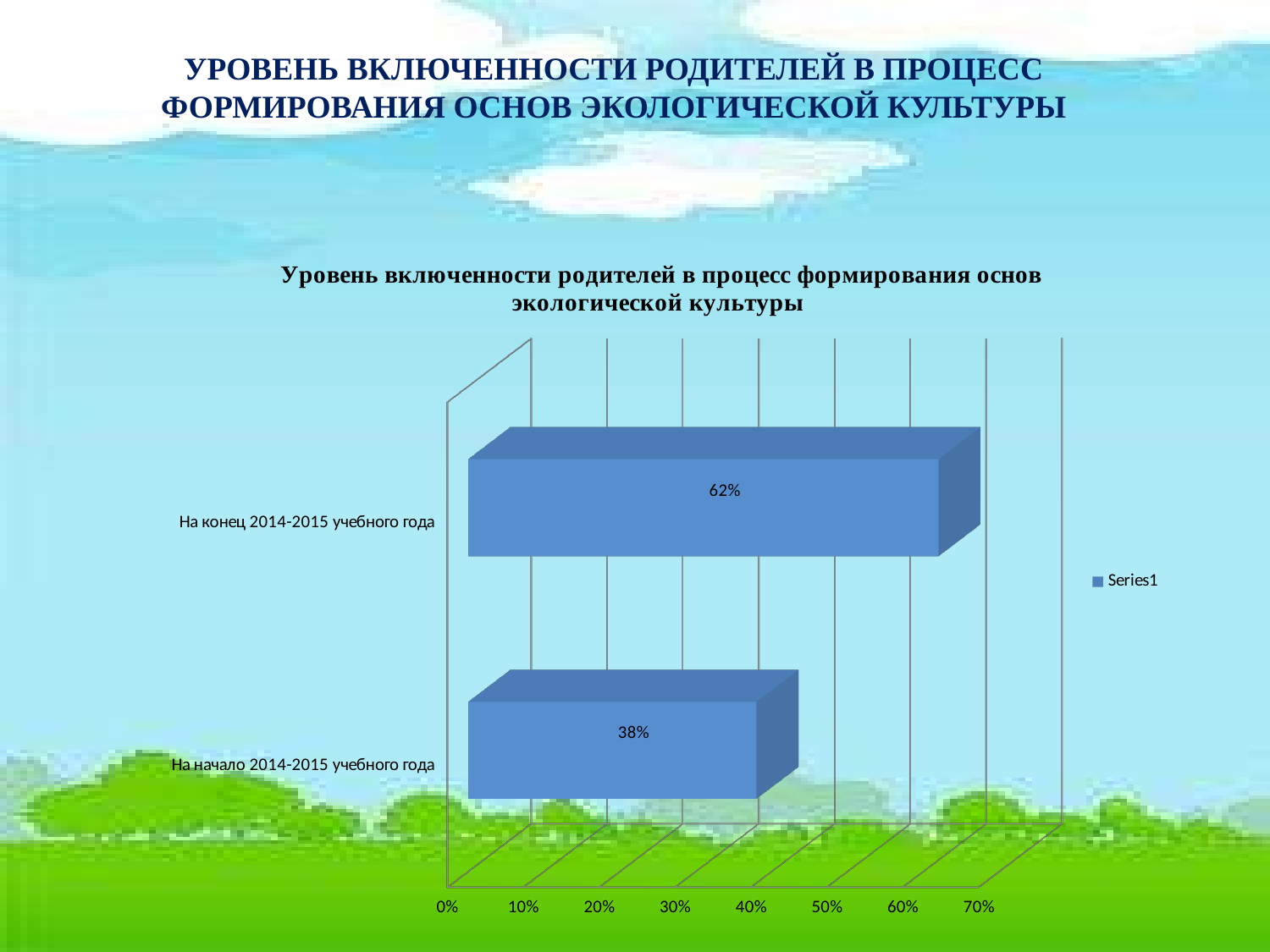
How many series does the legend list? 1 What is the difference between the value for «На конец 2014-2015 учебного года» and the value for «На начало 2014-2015 учебного года»? 24% Is the value for «На начало 2014-2015 учебного года» greater or less than 40%? less How many categories are shown in the chart? 2 Is the value for «На конец 2014-2015 учебного года» greater or less than 50%? greater What is the value for «На конец 2014-2015 учебного года»? 62% Which category has the highest value? На конец 2014-2015 учебного года What kind of chart is shown on the slide? Bar chart Which is larger: the value for «На начало 2014-2015 учебного года» or the value for «На конец 2014-2015 учебного года»? На конец 2014-2015 учебного года Which category has the lowest value? На начало 2014-2015 учебного года What is the name of the series shown in the legend? Series1 What is the value for «На начало 2014-2015 учебного года»? 38%